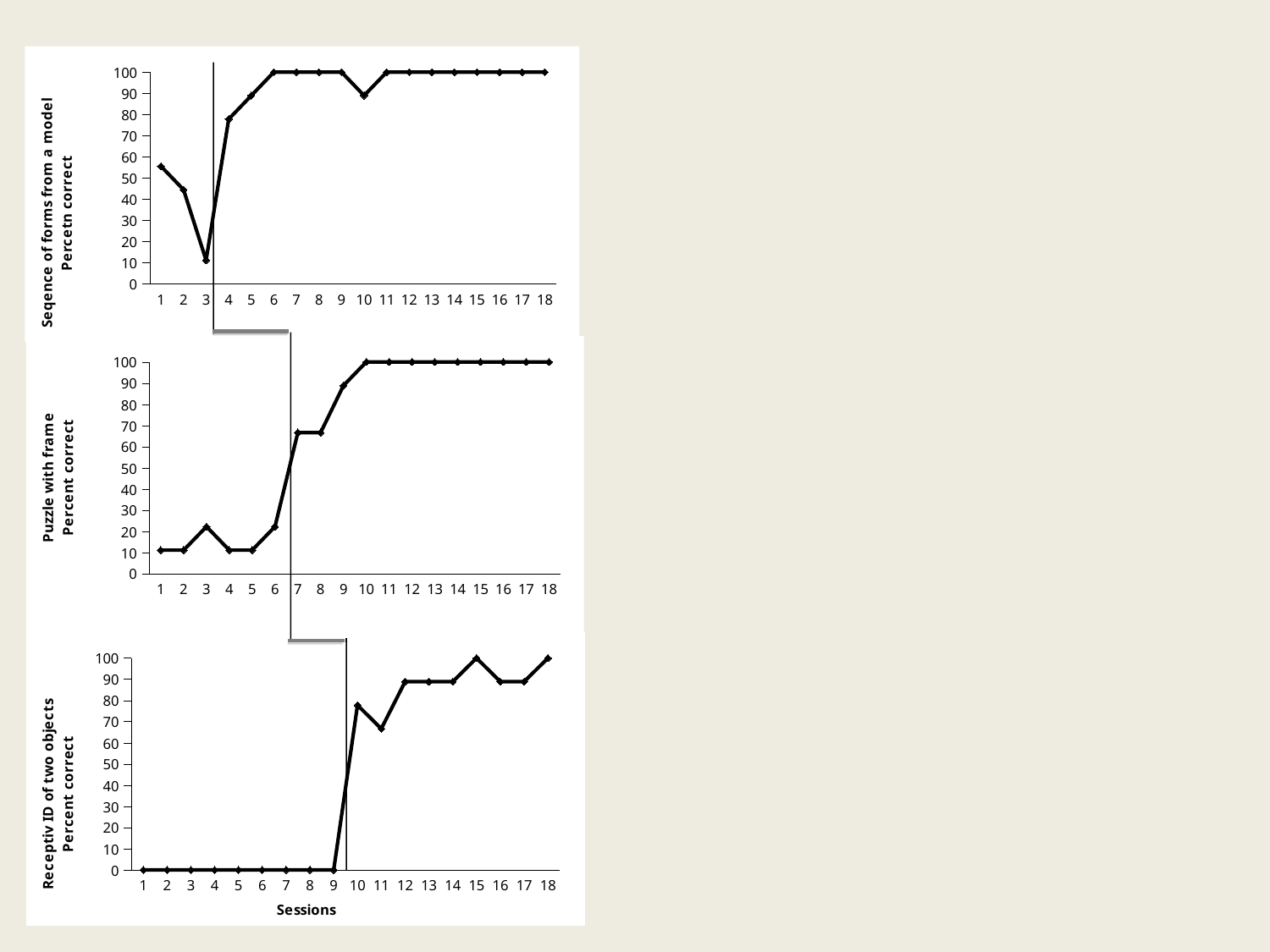
In the middle chart, 'Puzzle with frame', is the value for session 1 greater or less than 20? less What kind of chart is the top chart, 'Sequence of forms from a model'? line chart In the top chart, 'Sequence of forms from a model', which session has the lowest percent correct? 3 How many charts are shown on the slide? 3 In the top chart, 'Sequence of forms from a model', which is larger, the value for session 1 or session 2? session 1 In the middle chart, 'Puzzle with frame', do the values rise or fall from session 6 to session 10? rise In the bottom chart, 'Receptive ID of two objects', which is larger, the value for session 10 or session 11? session 10 In the top chart, 'Sequence of forms from a model', is the value for session 3 greater or less than 20? less In the top chart, 'Sequence of forms from a model', what is the percent correct at session 6? 100 How many sessions are plotted along the x axis of the bottom chart, 'Receptive ID of two objects'? 18 In the bottom chart, 'Receptive ID of two objects', what is the percent correct at session 5? 0 What is the x-axis label shown under the bottom chart? Sessions